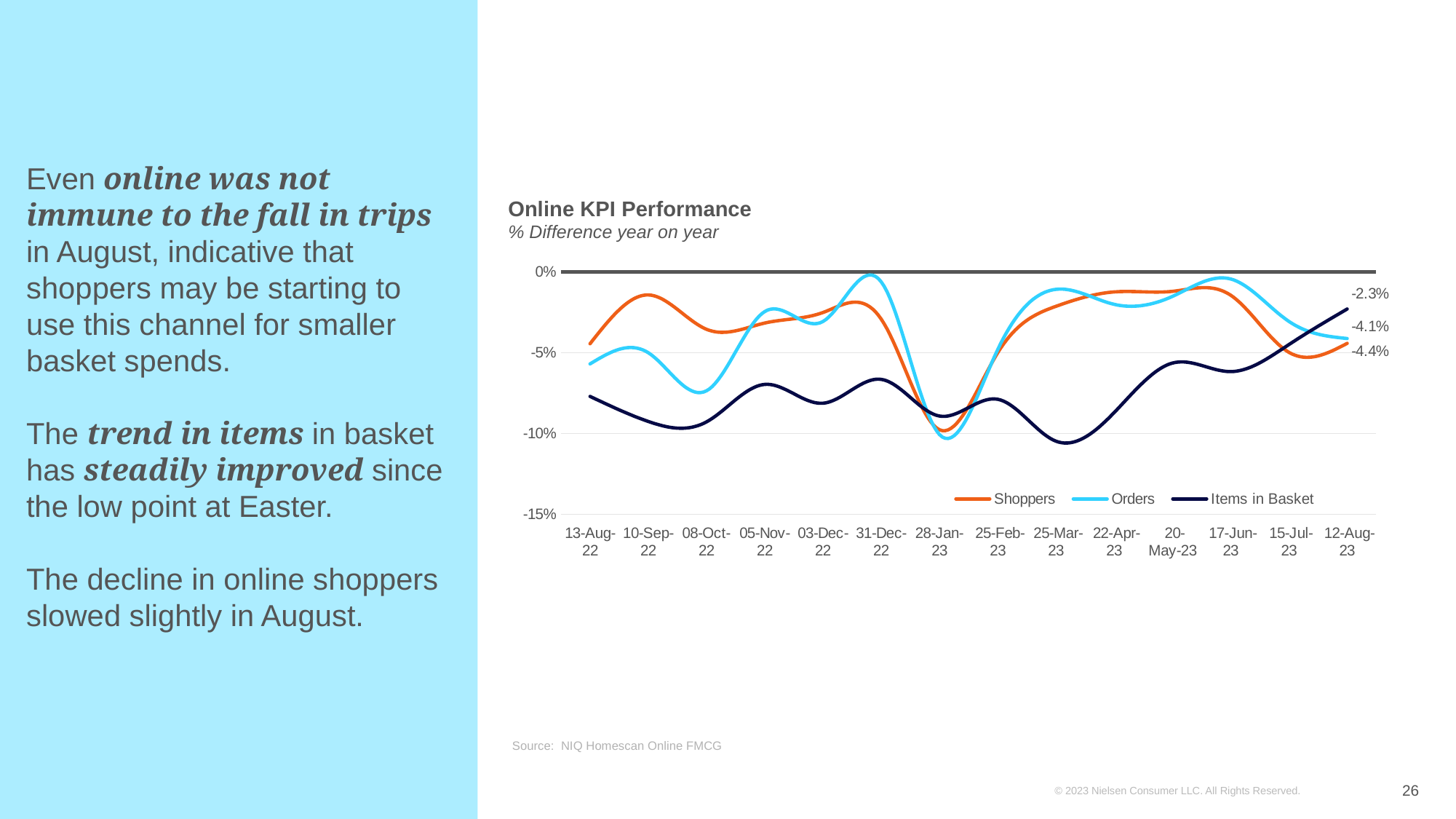
What kind of chart is shown on the slide? Line chart What is the value for Shoppers at 12-Aug-23? -4.4% What is the value for Orders at 12-Aug-23? -4.1% Does the Items in Basket line rise or fall between 25-Mar-23 and 12-Aug-23? Rises Which series has the lowest value at 25-Mar-23? Items in Basket At 12-Aug-23, what is the difference between the Items in Basket value and the Shoppers value? 2.1 percentage points Is the value for Shoppers at 10-Sep-22 greater or less than -5%? greater What is the subtitle shown under the chart title Online KPI Performance? % Difference year on year How many series does the legend of the Online KPI Performance chart list? 3 What is the value for Items in Basket at 12-Aug-23? -2.3% How many dates are shown on the x axis of the Online KPI Performance chart? 14 Which series has the highest value at 12-Aug-23? Items in Basket